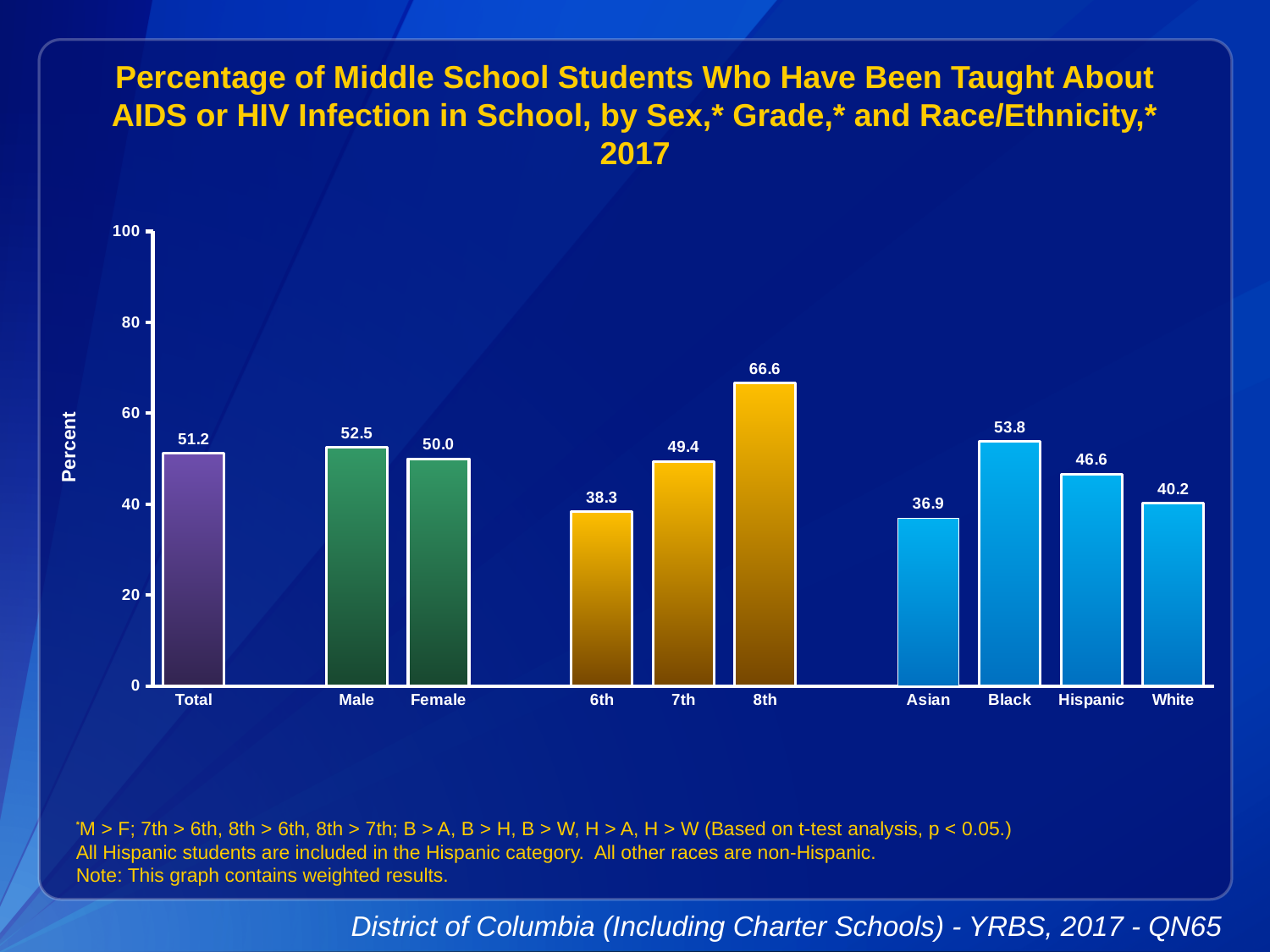
How many categories are shown on the x axis? 10 What is the difference between the values for Male and Female? 2.5 Which category has the highest value? 8th What kind of chart is this? bar chart Which category has the lowest value? Asian What is the value for Asian students? 36.9 What is the value for Total? 51.2 What is the value for 8th grade? 66.6 Is the value for White greater or less than 40? greater What is the label of the y axis? Percent What is the difference between the values for 8th and 6th grade? 28.3 Which is larger, the value for Black or the value for Hispanic? Black